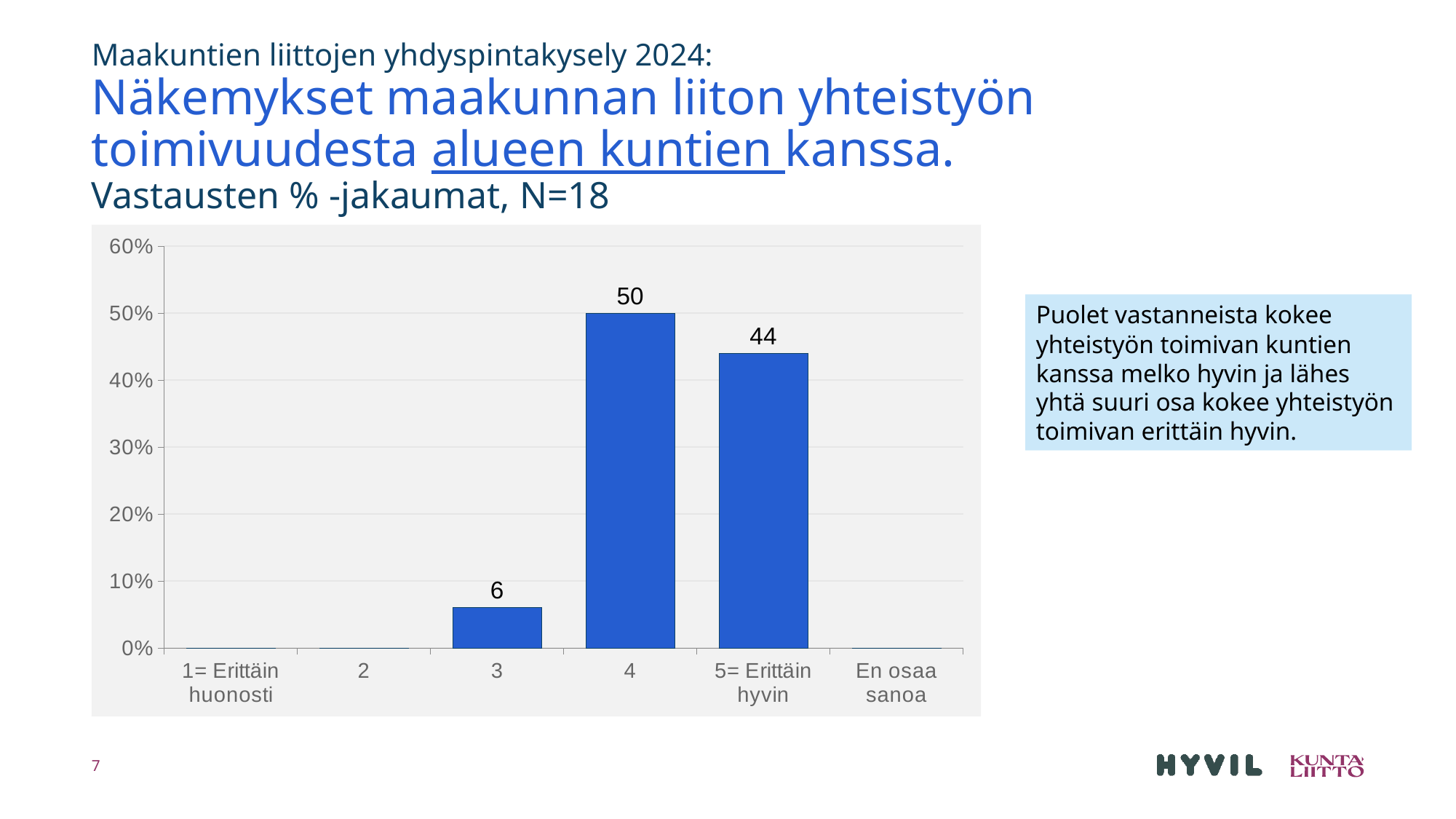
What is the value for category 3? 6 What is the difference between the values for category 4 and category '5= Erittäin hyvin'? 6 Which is larger, the value for category 3 or the value for category 4? 4 What is the highest value shown on the y axis? 60% What kind of chart is shown on the slide? bar chart How many categories are shown on the x axis? 6 Which category has the highest value? 4 What is the value for category 4? 50 Is the value for category '5= Erittäin hyvin' greater or less than 40%? greater What is the difference between the values for category 4 and category 3? 44 Is the value for category 3 greater or less than 10%? less What is the value for the category '5= Erittäin hyvin'? 44